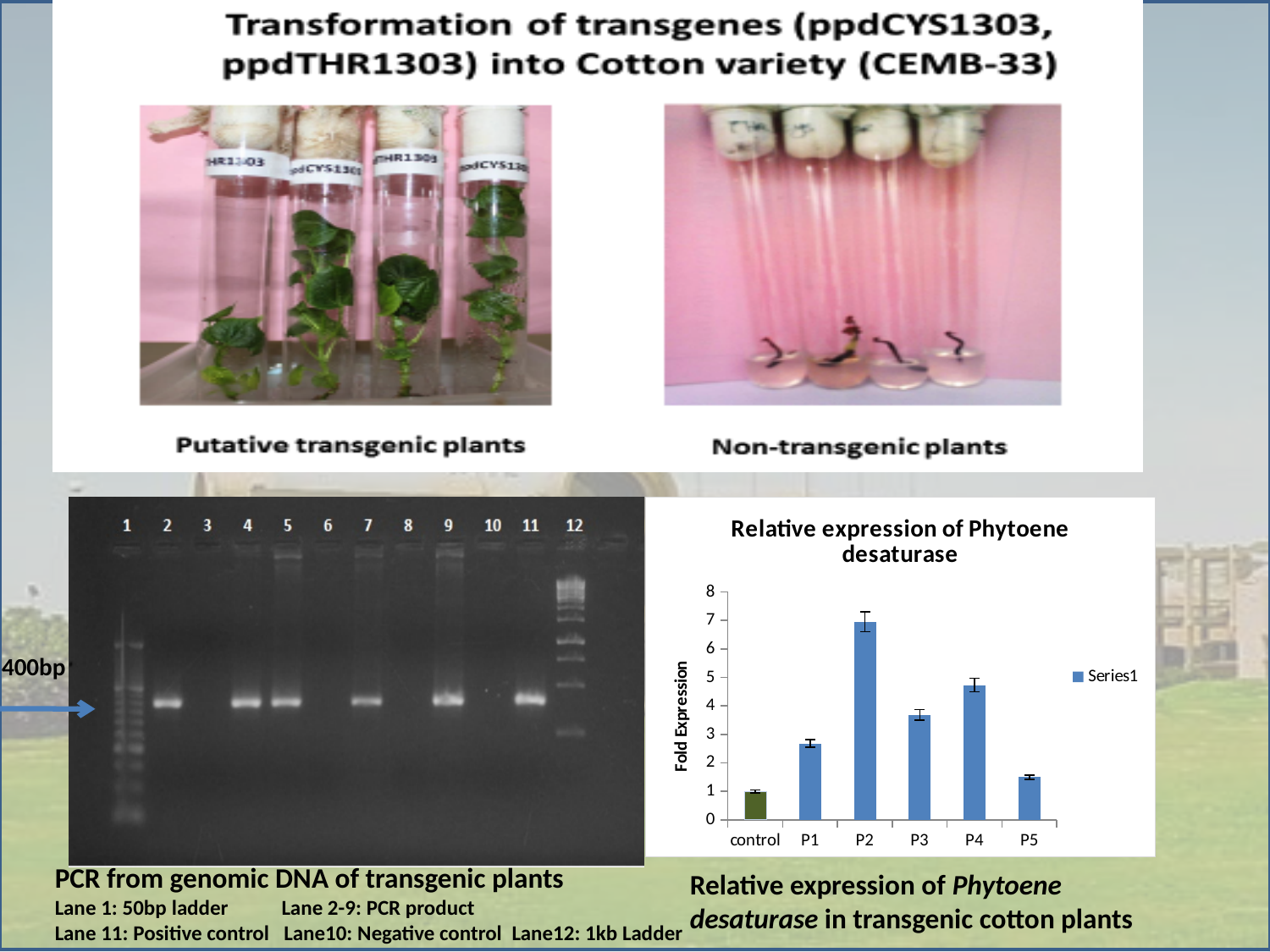
What is the label of the y axis of the chart? Fold Expression Which has a higher fold expression, P3 or P4? P4 Is the fold expression for P4 greater or less than 4? greater What is the title of the chart on the slide? Relative expression of Phytoene desaturase Which has a higher fold expression, P1 or P5? P1 How many series does the chart legend list? 1 How many categories are plotted on the x axis of the chart? 6 What kind of chart is shown on the slide? bar chart Is the fold expression for P2 greater or less than 6? greater Is the fold expression for P5 greater or less than 2? less Which category has the highest fold expression in the chart? P2 Which category has the lowest fold expression in the chart? control